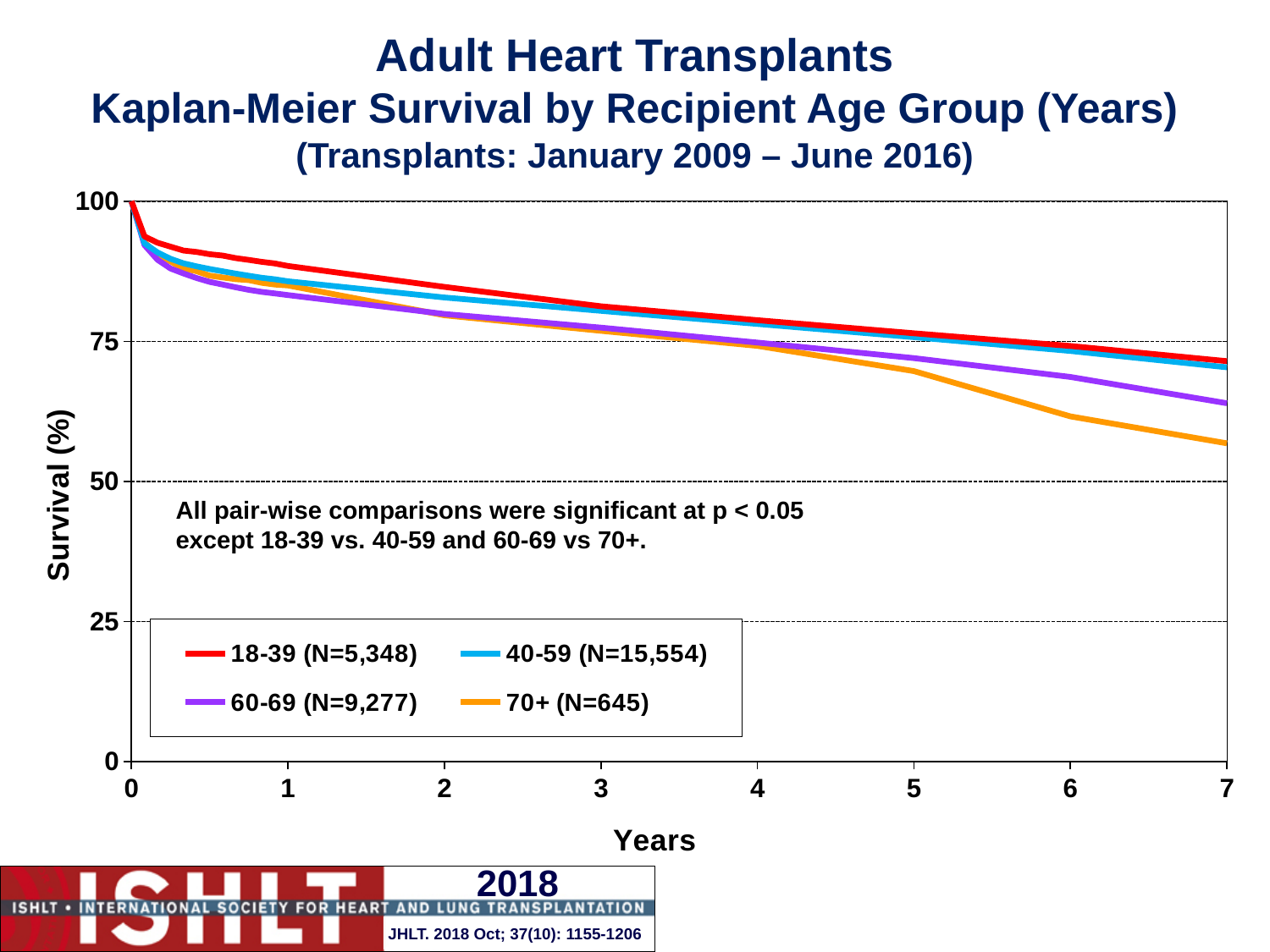
Which age group has the highest survival at 1 year? 18-39 What is the N shown in the legend for the 40-59 age group? N=15,554 At 7 years, is survival higher for the 60-69 group or the 70+ group? 60-69 Do the survival curves rise or fall as years since transplant increase? Fall Is the survival for the 70+ group at 7 years greater or less than 50? greater Which pair-wise comparisons were not significant at p < 0.05 according to the note on the chart? 18-39 vs. 40-59 and 60-69 vs 70+ What kind of chart is shown on the slide? Line chart At 1 year, is survival higher for the 18-39 group or the 60-69 group? 18-39 Which age group has the lowest survival at 7 years? 70+ Is the survival for the 60-69 group at 7 years greater or less than 75? less How many series does the legend list? 4 Is the survival for the 18-39 group at 1 year greater or less than 75? greater